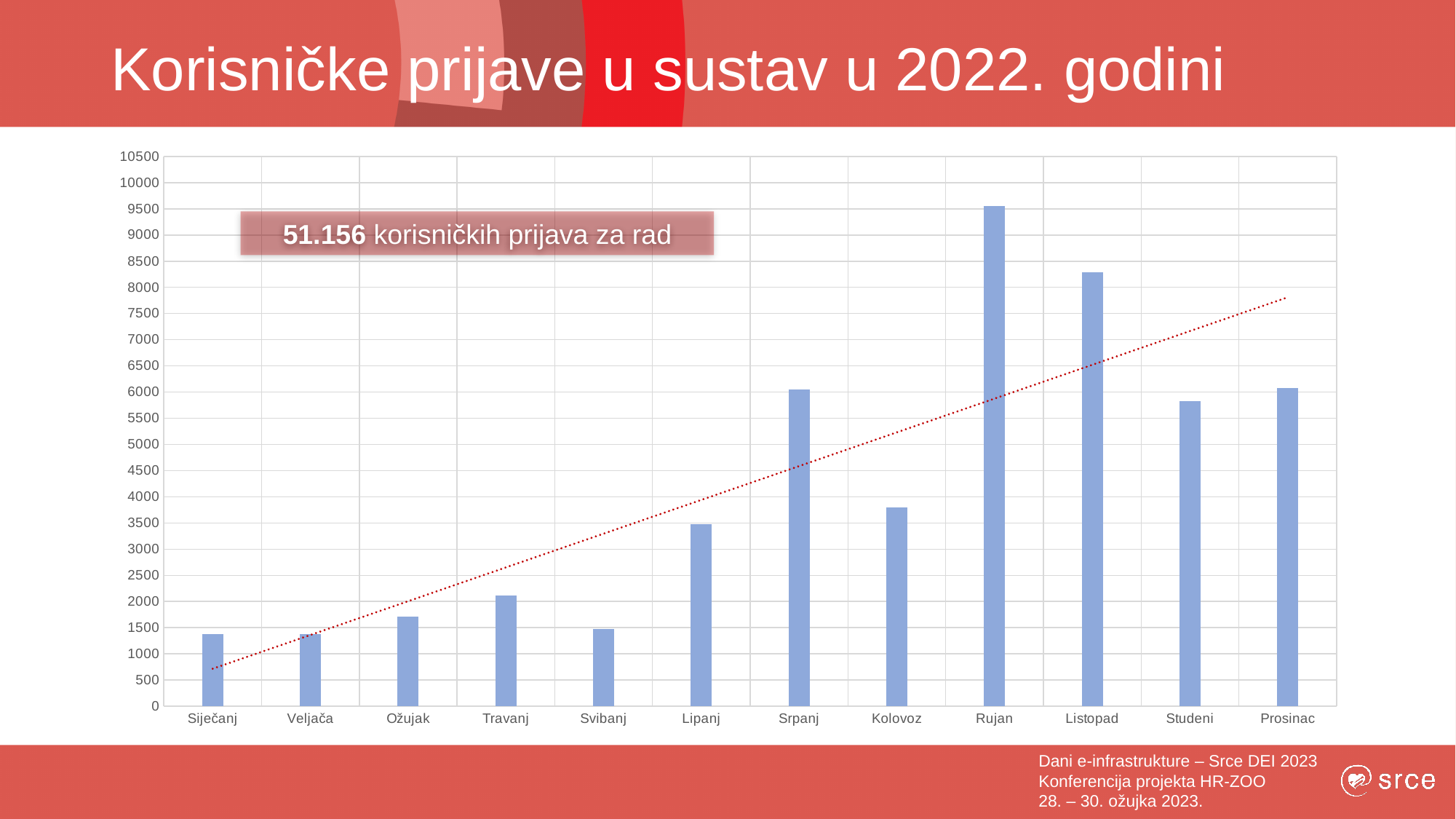
What kind of chart is shown on the slide? bar chart Which month has the highest number of user logins in the chart? Rujan How many months (categories) are shown on the x axis of the chart? 12 Is the value for Travanj greater or less than 2000? greater Is the value for Studeni greater or less than 5500? greater Is the value for Listopad greater or less than 8000? greater Which is larger, the value for Rujan or the value for Listopad? Rujan Do the values generally rise or fall from Siječanj to Prosinac, as indicated by the dotted trend line? rise What total number of user logins is stated in the text box on the chart? 51.156